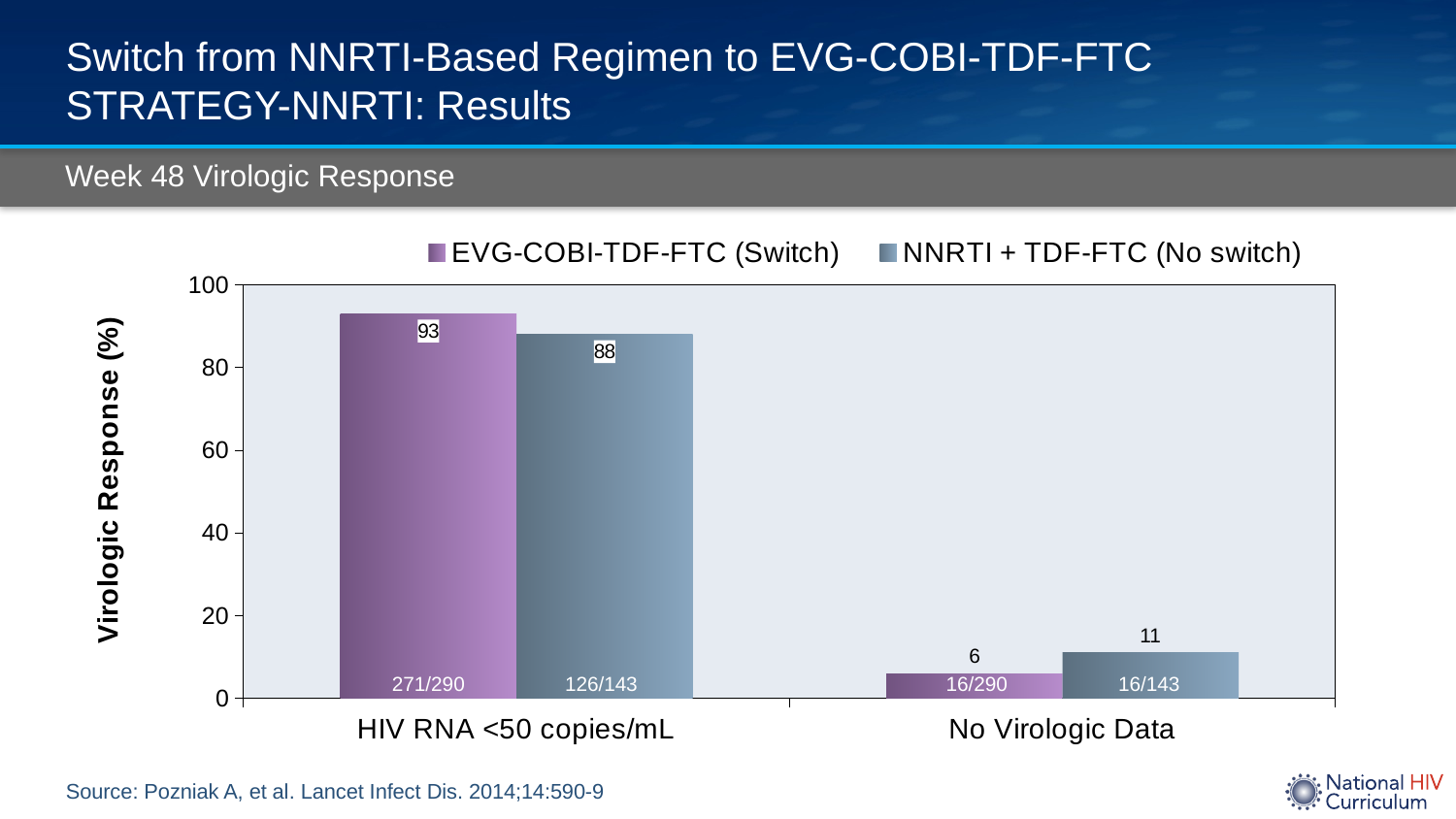
Which series has the higher value in the No Virologic Data category? NNRTI + TDF-FTC (No switch) What is the virologic response (%) for EVG-COBI-TDF-FTC (Switch) in the HIV RNA <50 copies/mL category? 93 What is the value for EVG-COBI-TDF-FTC (Switch) in the No Virologic Data category? 6 What fraction of patients is shown inside the NNRTI + TDF-FTC (No switch) bar for No Virologic Data? 16/143 Which series has the higher value in the HIV RNA <50 copies/mL category? EVG-COBI-TDF-FTC (Switch) How many categories are shown on the x axis? 2 What is the virologic response (%) for NNRTI + TDF-FTC (No switch) in the HIV RNA <50 copies/mL category? 88 What is the value for NNRTI + TDF-FTC (No switch) in the No Virologic Data category? 11 What fraction of patients is shown inside the EVG-COBI-TDF-FTC (Switch) bar for HIV RNA <50 copies/mL? 271/290 What is the difference in percentage points between the two series in the HIV RNA <50 copies/mL category? 5 How many series does the legend list? 2 What type of chart is shown on the slide? Bar chart